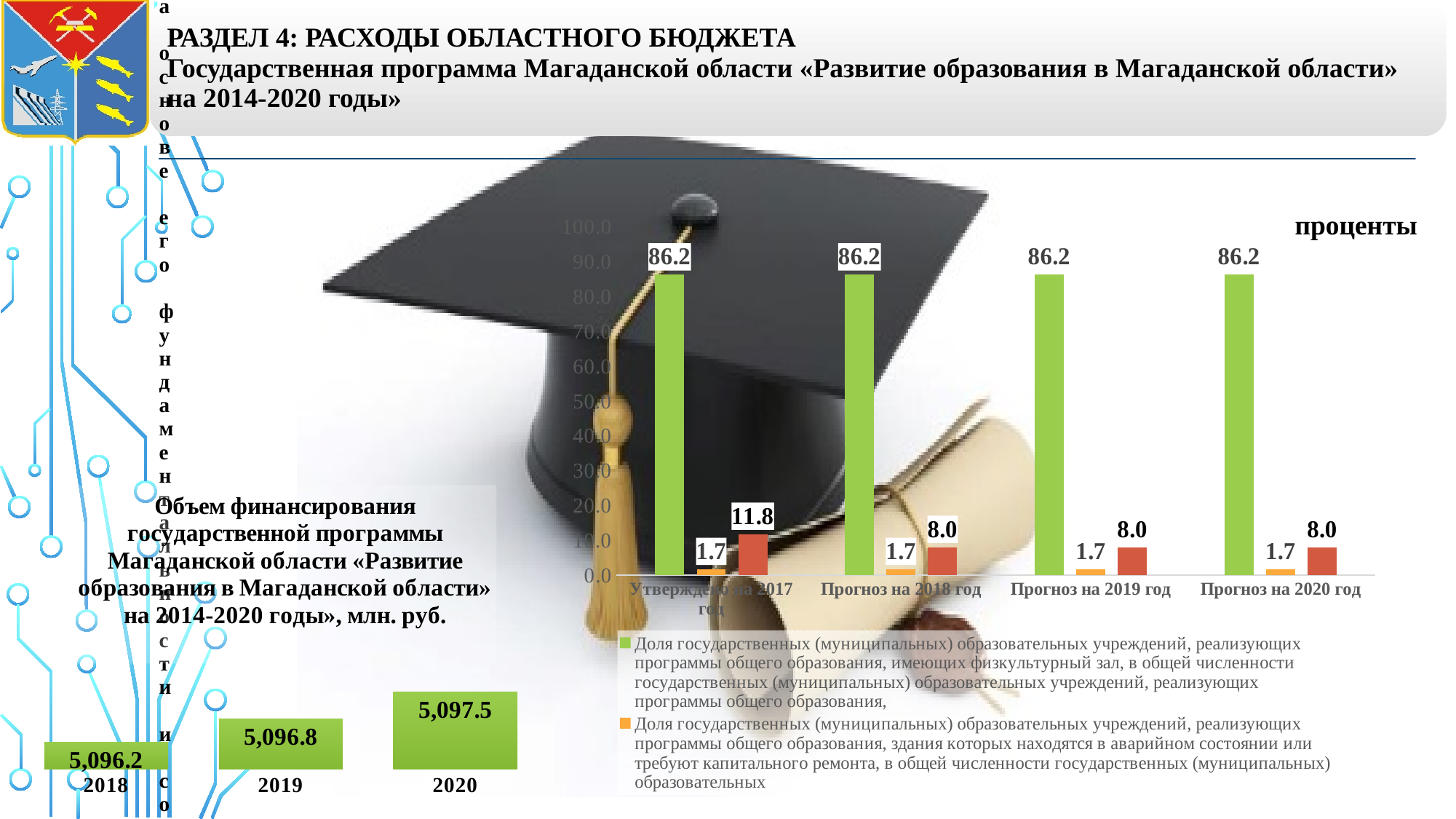
In the chart titled «Объем финансирования государственной программы Магаданской области «Развитие образования в Магаданской области» на 2014-2020 годы», млн. руб.», what is the value for 2019? 5,096.8 In the chart titled «Объем финансирования ... млн. руб.» on the left, which year has the lowest value? 2018 In the chart labelled «проценты» on the right, what is the value of the orange bar for «Прогноз на 2020 год»? 1.7 In the chart labelled «проценты» on the right, what is the value of the green bar for «Прогноз на 2019 год»? 86.2 In the chart titled «Объем финансирования ... млн. руб.» on the left, do the values rise or fall from 2018 to 2020? rise In the chart labelled «проценты» on the right, what is the difference between the red bar values for «Утверждено на 2017 год» and «Прогноз на 2018 год»? 3.8 In the chart titled «Объем финансирования ... млн. руб.» on the left, how many years are shown? 3 In the chart titled «Объем финансирования ... млн. руб.» on the left, what is the difference between the values for 2020 and 2018? 1.3 In the chart labelled «проценты» on the right, how many categories are shown on the x axis? 4 In the chart titled «Объем финансирования ... млн. руб.» on the left, which year has the highest value? 2020 In the chart labelled «проценты» on the right, what is the value of the red bar for «Утверждено на 2017 год»? 11.8 What kind of chart is the chart labelled «проценты» on the right? bar chart